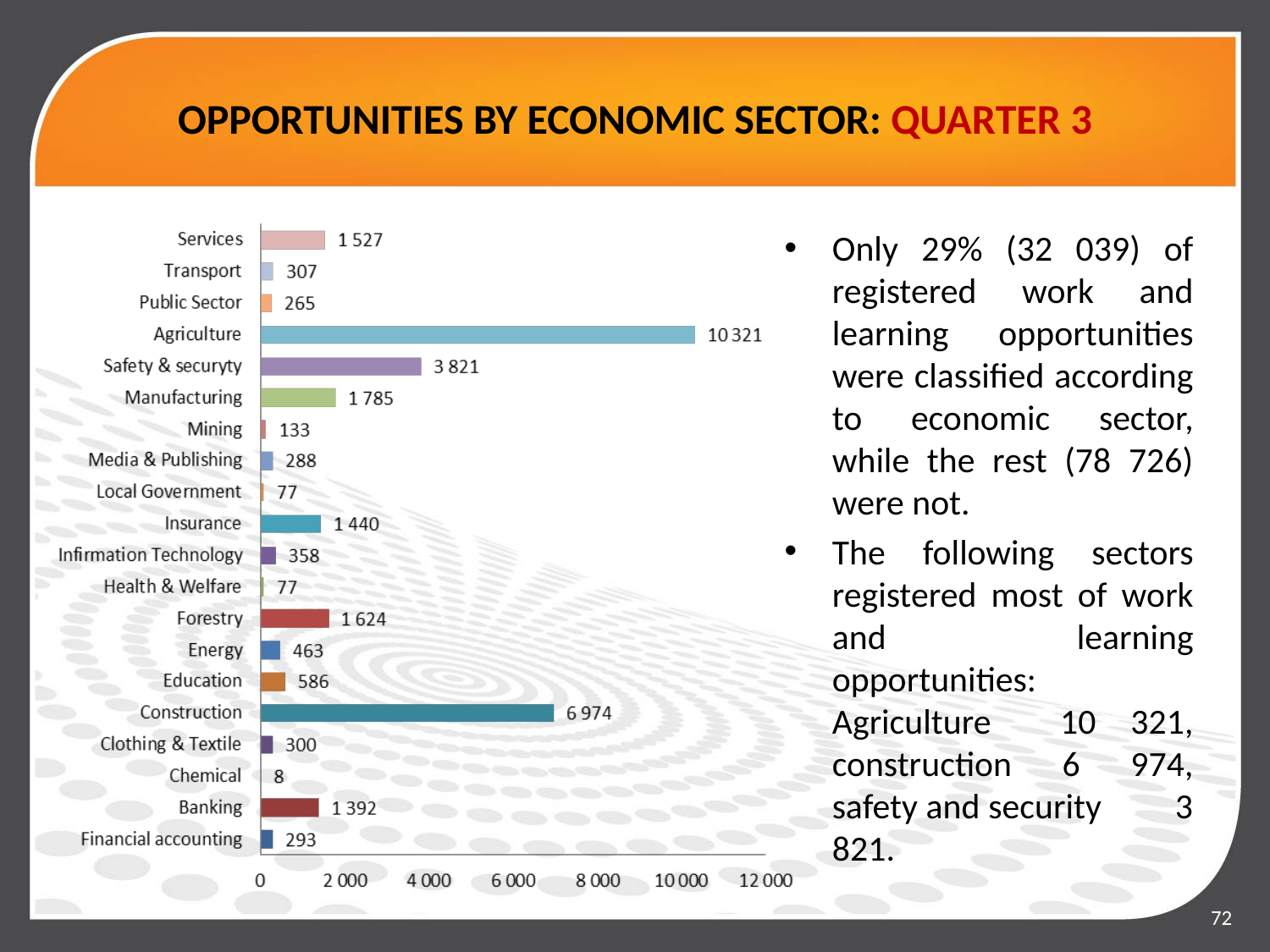
What kind of chart is shown on the slide? bar chart Which sector has the lowest value? Chemical Is the value for Safety & securyty greater or less than 4 000? less What is the difference between the values for Manufacturing and Forestry? 161 Which is larger, the value for Banking or the value for Insurance? Insurance How many sectors are shown in the chart? 20 What is the value for Insurance? 1 440 What is the value for Mining? 133 What is the difference between the values for Agriculture and Construction? 3 347 What is the value for Construction? 6 974 Which sector has the highest value? Agriculture What is the value for Agriculture? 10 321